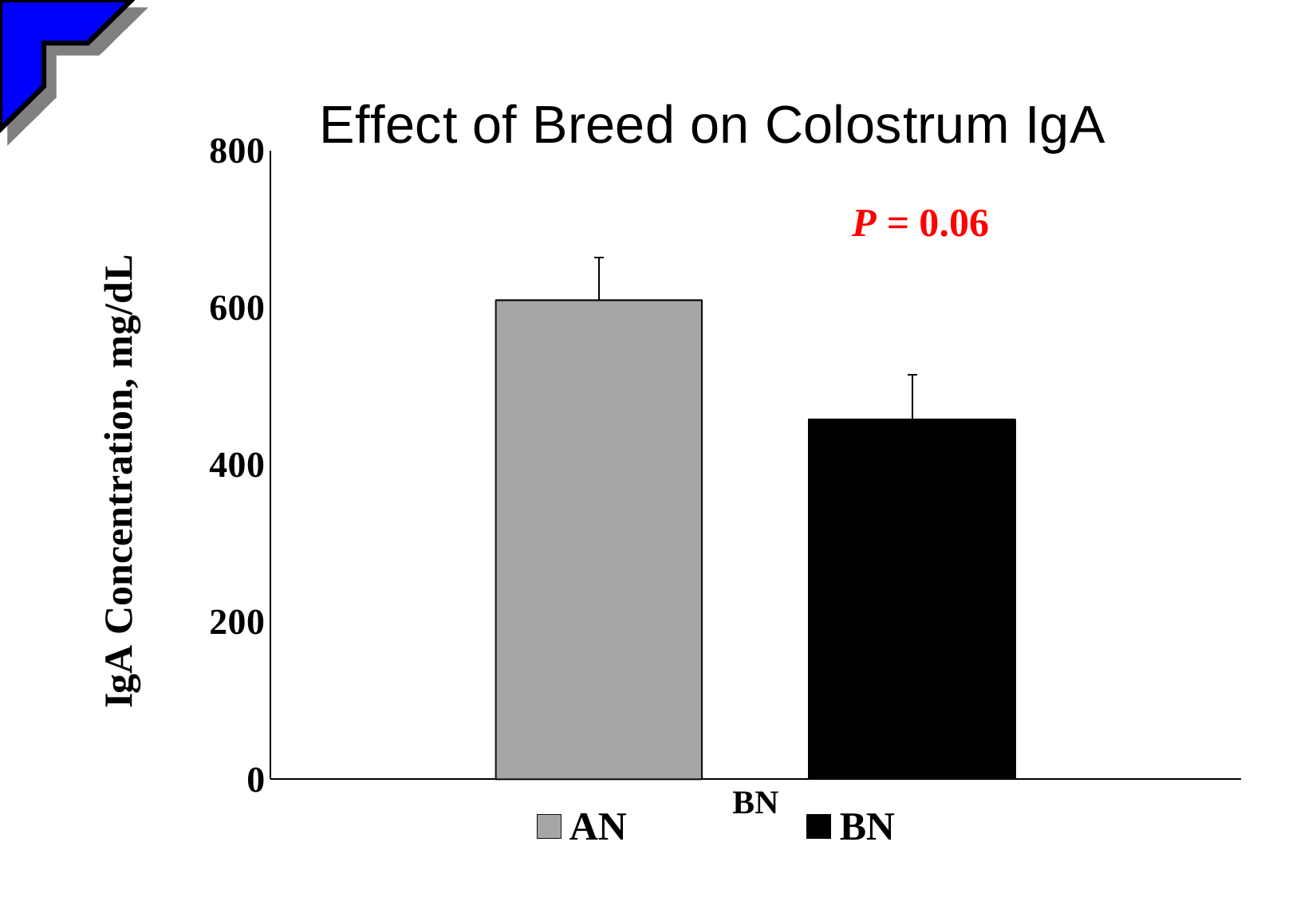
What is the title of the chart? Effect of Breed on Colostrum IgA Is the IgA concentration for AN larger or smaller than that for BN? larger What kind of chart is shown on the slide? bar chart Is the value for BN greater or less than 600? less Is the value for BN greater or less than 400? greater Which breed has the higher IgA concentration? AN Which breed has the lower IgA concentration? BN How many bars are plotted in the chart? 2 How many series does the legend list? 2 What P value is shown on the chart? P = 0.06 Is the value for AN greater or less than 400? greater